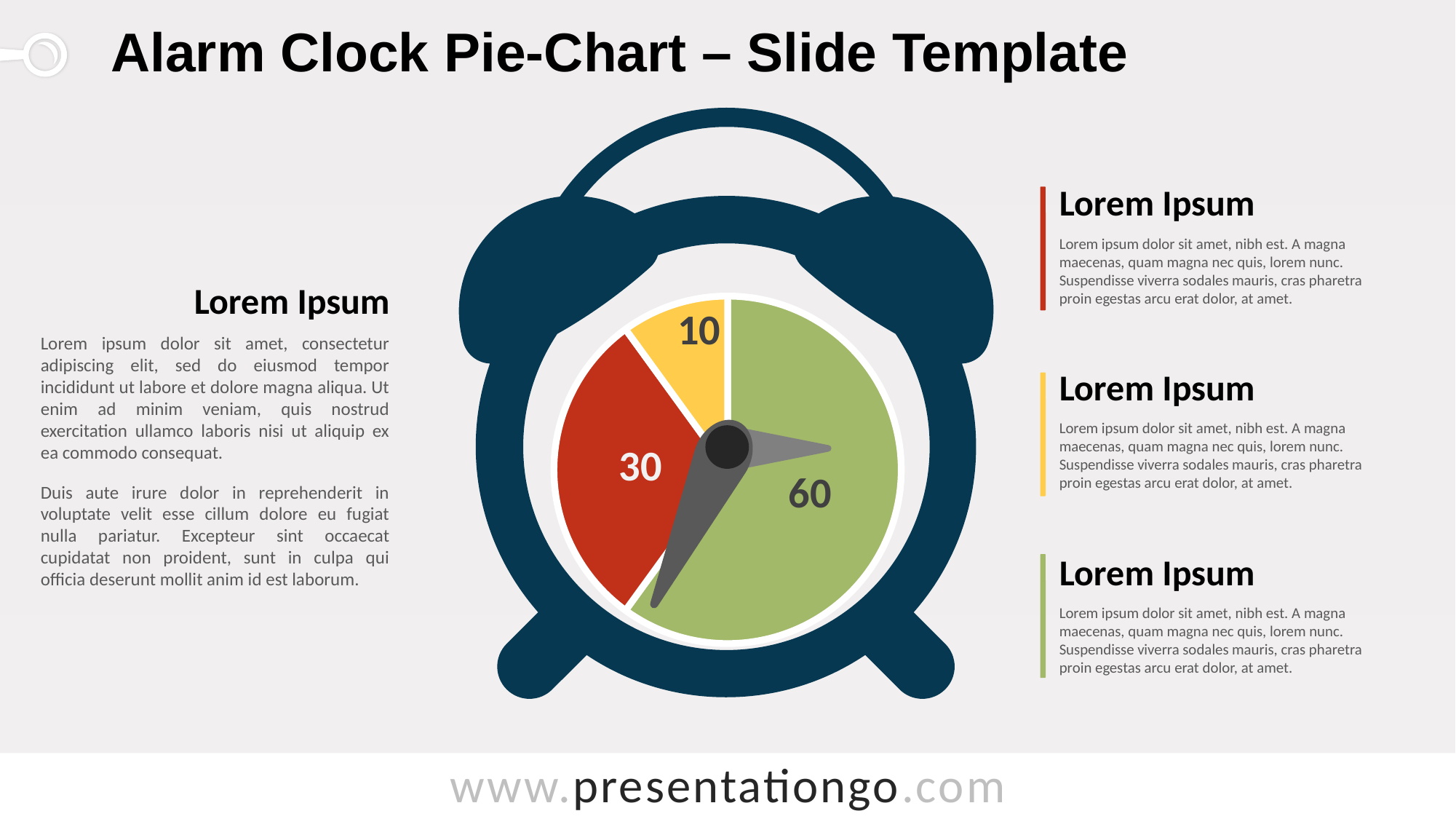
What type of chart is shown inside the alarm clock? pie chart Which slice of the pie chart has the smallest value? the yellow slice (10) Which slice of the pie chart has the largest value? the green slice (60) What is the total of the three values shown on the pie chart? 100 Which is larger, the value of the red slice or the value of the yellow slice? the red slice What value is printed on the red slice of the pie chart? 30 What is the title of the slide containing the pie chart? Alarm Clock Pie-Chart – Slide Template What value is printed on the green slice of the pie chart? 60 What is the difference between the values of the green slice and the red slice? 30 What share of the pie does the green slice represent? 60% What value is printed on the yellow slice of the pie chart? 10 How many slices does the pie chart have? 3